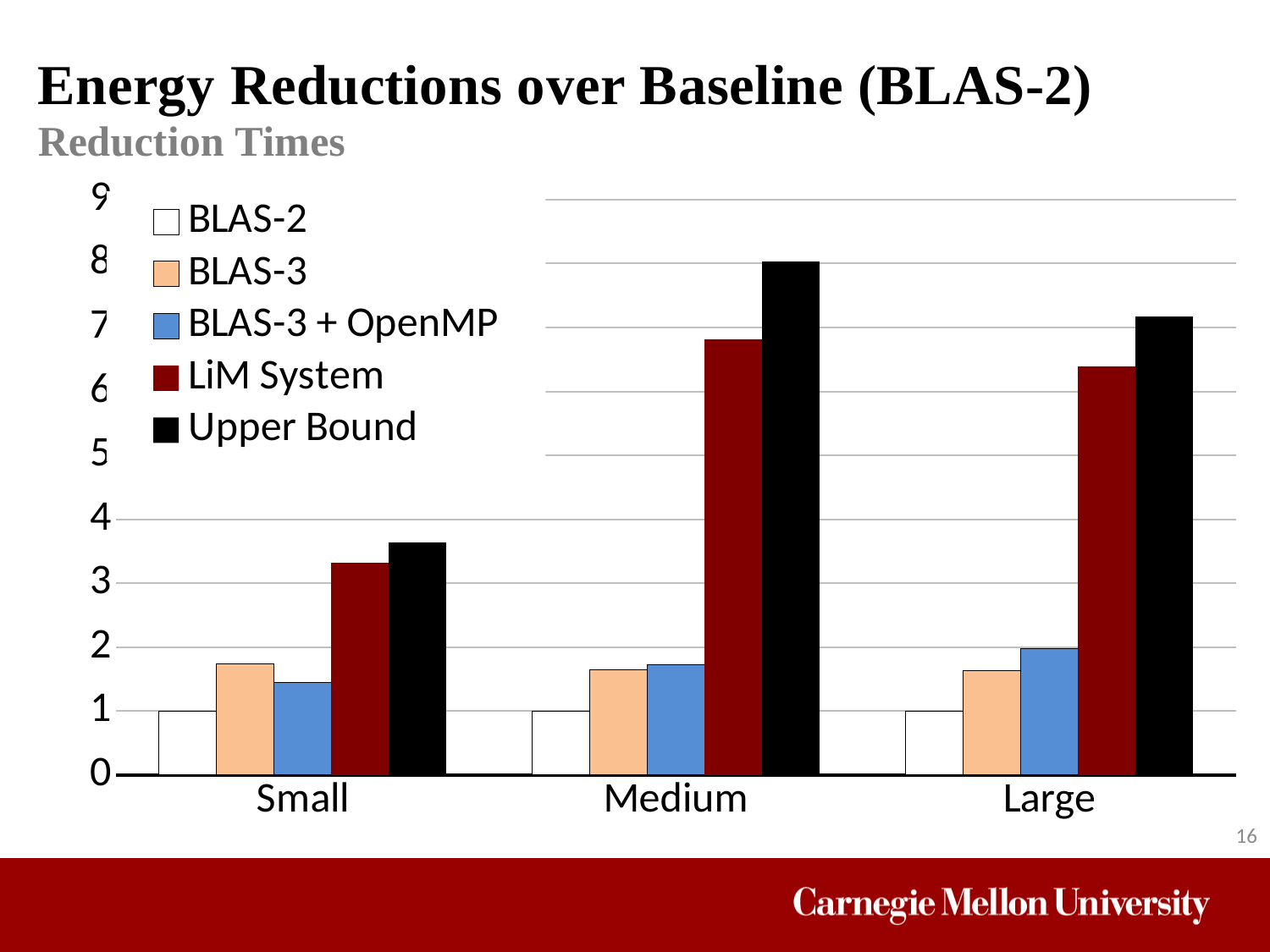
In the Small category, which is larger: BLAS-3 or BLAS-3 + OpenMP? BLAS-3 Which category has the highest Upper Bound value? Medium Is the value for LiM System in the Medium category greater or less than 6? greater What is the title of the slide? Energy Reductions over Baseline (BLAS-2) In the Large category, which is larger: BLAS-3 or BLAS-3 + OpenMP? BLAS-3 + OpenMP Which series has the lowest value in the Medium category? BLAS-2 What is the value for BLAS-2 in the Small category? 1 Is the value for Upper Bound in the Small category greater or less than 4? less What kind of chart is shown on the slide? bar chart How many categories are shown on the x axis? 3 How many series does the legend list? 5 Is the value for LiM System in the Large category greater or less than 7? less